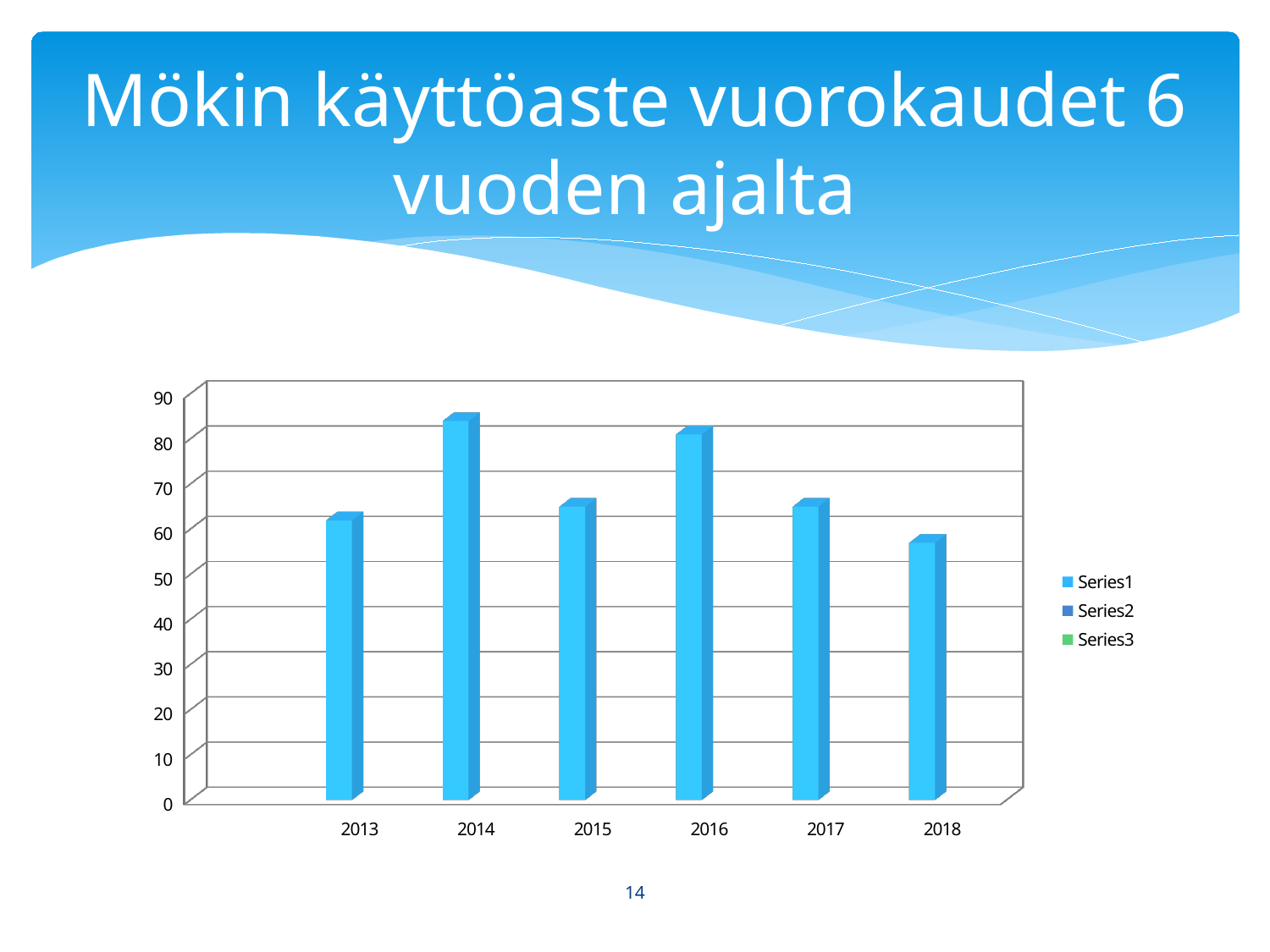
Is the value for 2018 greater or less than 60? less What kind of chart is shown on the slide? bar chart What is the title of the slide containing the chart? Mökin käyttöaste vuorokaudet 6 vuoden ajalta Which year has the larger value, 2014 or 2013? 2014 Do the values rise or fall from 2016 to 2018? fall How many series does the chart legend list? 3 Which year has the lowest bar in the chart? 2018 How many years are shown on the x axis of the chart? 6 Is the value for 2016 greater or less than 70? greater Which year has the highest bar in the chart? 2014 Is the value for 2014 greater or less than 80? greater Which year has the larger value, 2016 or 2018? 2016